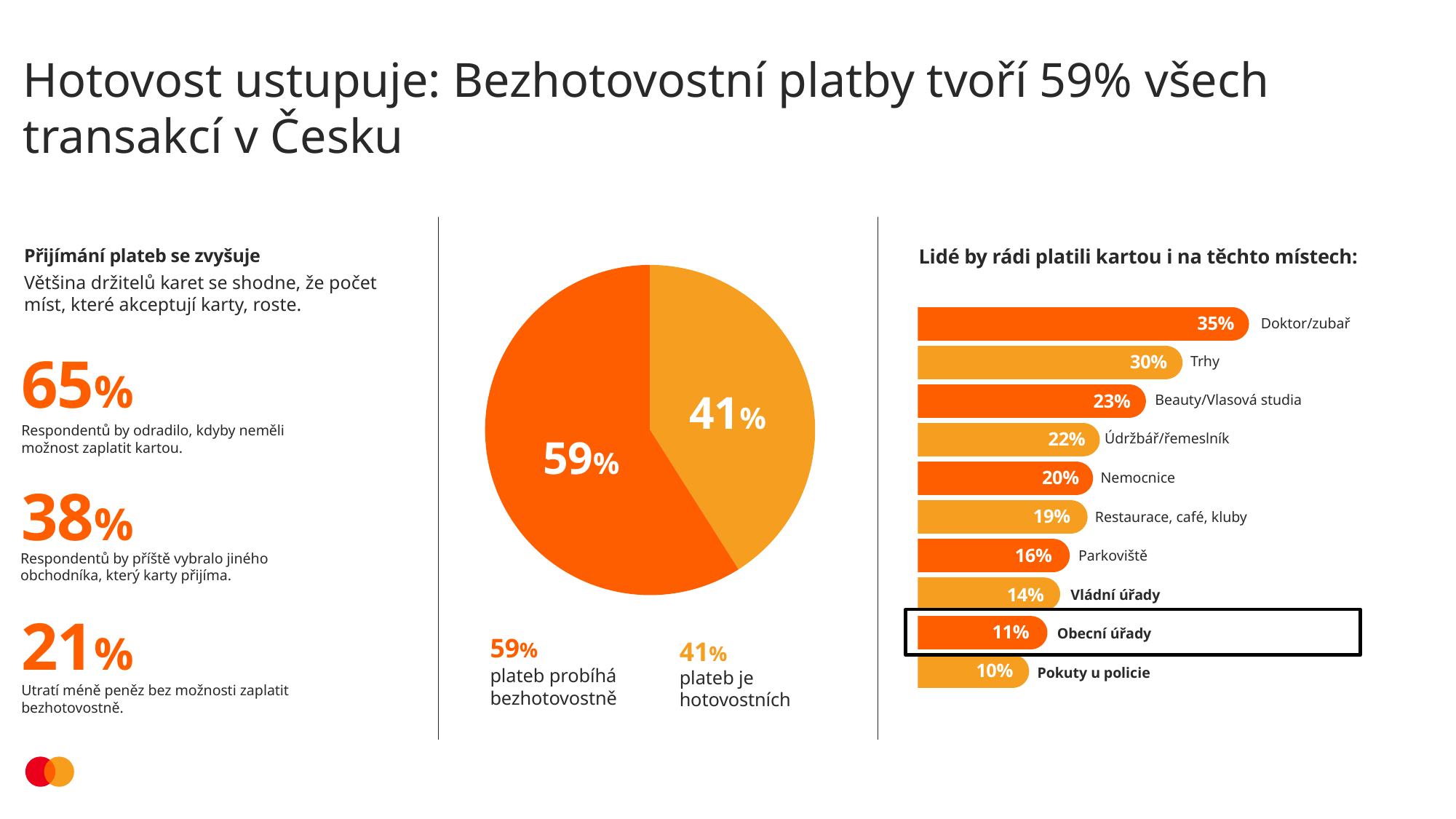
In the bar chart titled 'Lidé by rádi platili kartou i na těchto místech', what is the difference between Trhy and Parkoviště? 14% In the bar chart titled 'Lidé by rádi platili kartou i na těchto místech', what is the value for Doktor/zubař? 35% In the bar chart titled 'Lidé by rádi platili kartou i na těchto místech', which category has the highest value? Doktor/zubař What kind of chart is shown on the right side of the slide? Bar chart What kind of chart is shown in the middle of the slide? Pie chart How many categories are shown in the bar chart titled 'Lidé by rádi platili kartou i na těchto místech'? 10 How many slices does the pie chart in the middle of the slide have? 2 In the bar chart titled 'Lidé by rádi platili kartou i na těchto místech', which category has the lowest value? Pokuty u policie In the pie chart in the middle of the slide, what share of payments is cashless (bezhotovostně)? 59% In the bar chart titled 'Lidé by rádi platili kartou i na těchto místech', which is larger: Vládní úřady or Obecní úřady? Vládní úřady In the bar chart titled 'Lidé by rádi platili kartou i na těchto místech', what is the value for Nemocnice? 20% In the pie chart in the middle of the slide, what share of payments is cash (hotovostních)? 41%